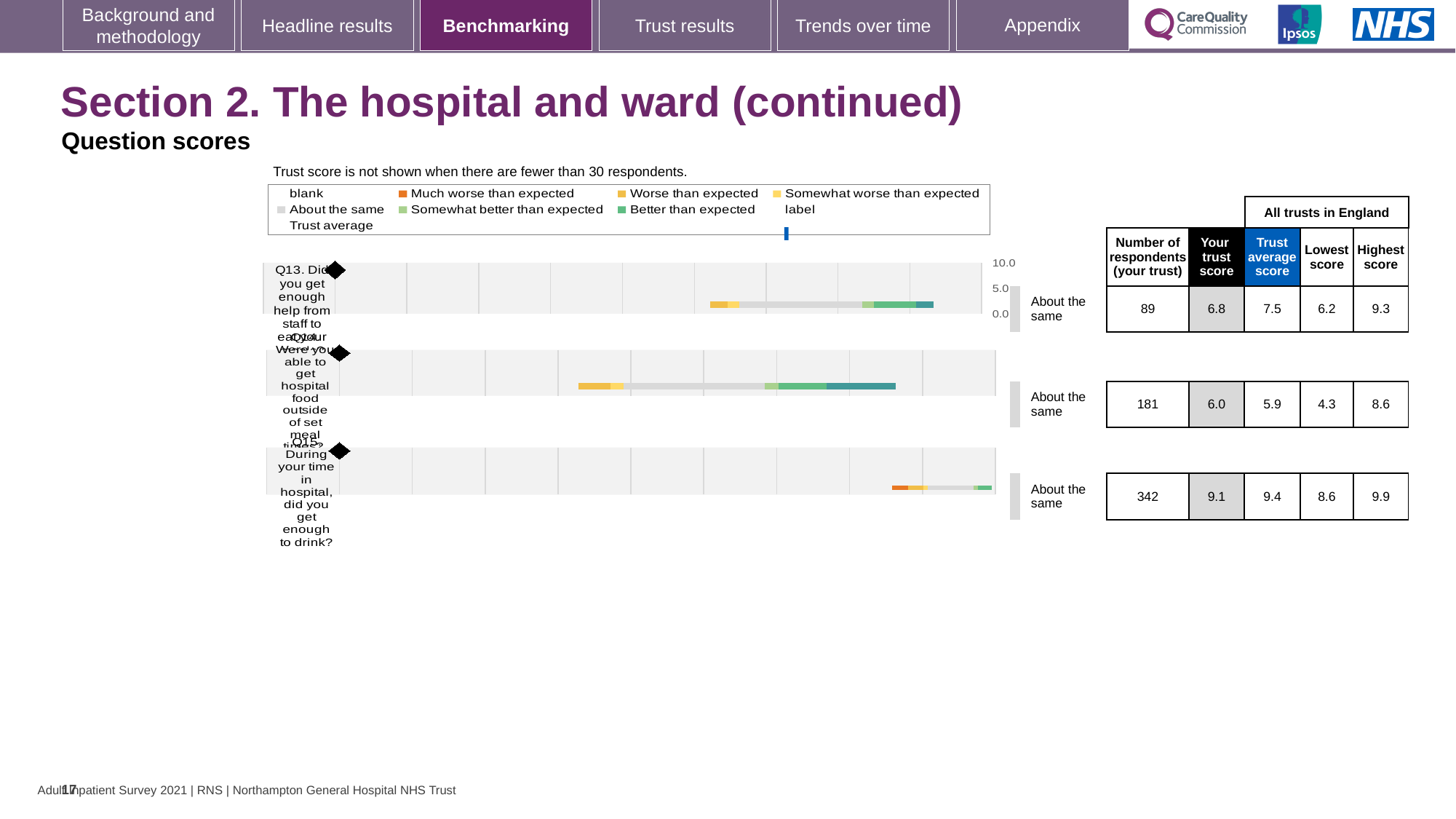
For Q14, which is larger: the trust score or the trust average score? the trust score How many respondents answered Q15 (did you get enough to drink?)? 342 What is the trust score for Q13 (Did you get enough help from staff to eat your meals?)? 6.8 What benchmark category is shown for Q13? About the same What is the trust average score for Q15? 9.4 What is the difference between the highest score and the lowest score for Q15? 1.3 How many questions (categories) are plotted in the chart? 3 What is the lowest score across all trusts in England for Q14? 4.3 Which question has the highest trust score? Q15 Which question has the fewest respondents? Q13 What kind of chart is used to show the question scores on this slide? bar chart For Q13, how much higher is the trust average score than the trust score? 0.7